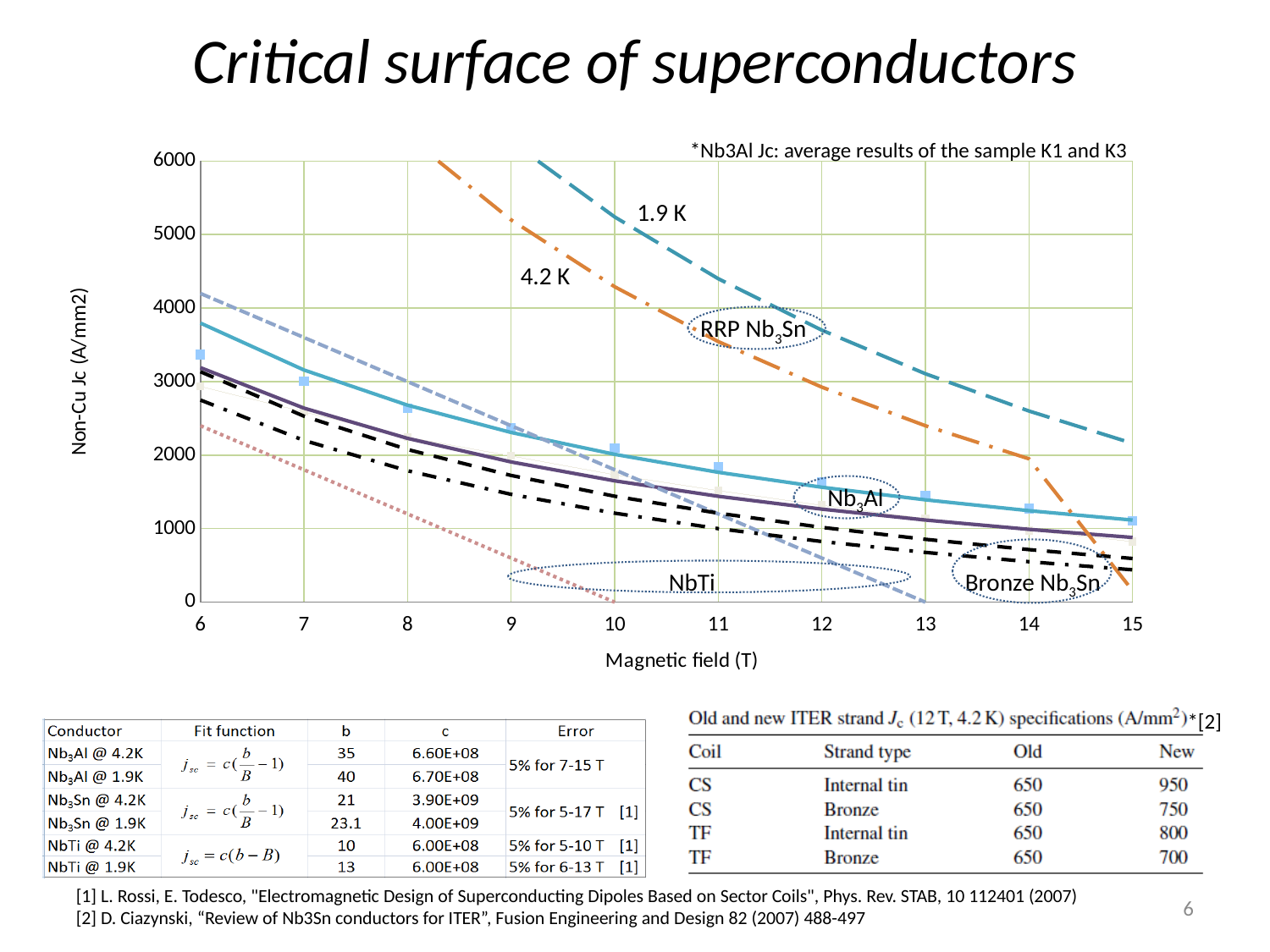
Do the Non-Cu Jc values rise or fall as the magnetic field increases? fall Which conductor has the lowest Non-Cu Jc at 9 T? NbTi Is the value of the 1.9 K RRP Nb3Sn curve at 15 T greater or less than 1000? greater At 12 T, which is higher: the 1.9 K RRP Nb3Sn curve or the Nb3Al curve with square markers? 1.9 K RRP Nb3Sn What is the highest value shown on the y axis of the chart? 6000 Is the value of the 4.2 K RRP Nb3Sn curve at 10 T greater or less than 3000? greater What is the label of the y axis of the chart? Non-Cu Jc (A/mm2) Is the value of the Nb3Al curve with square markers at 15 T greater or less than 2000? less What is the label of the x axis of the chart? Magnetic field (T) What kind of chart is shown on the slide? line chart How many tick values are labelled on the x axis of the chart? 10